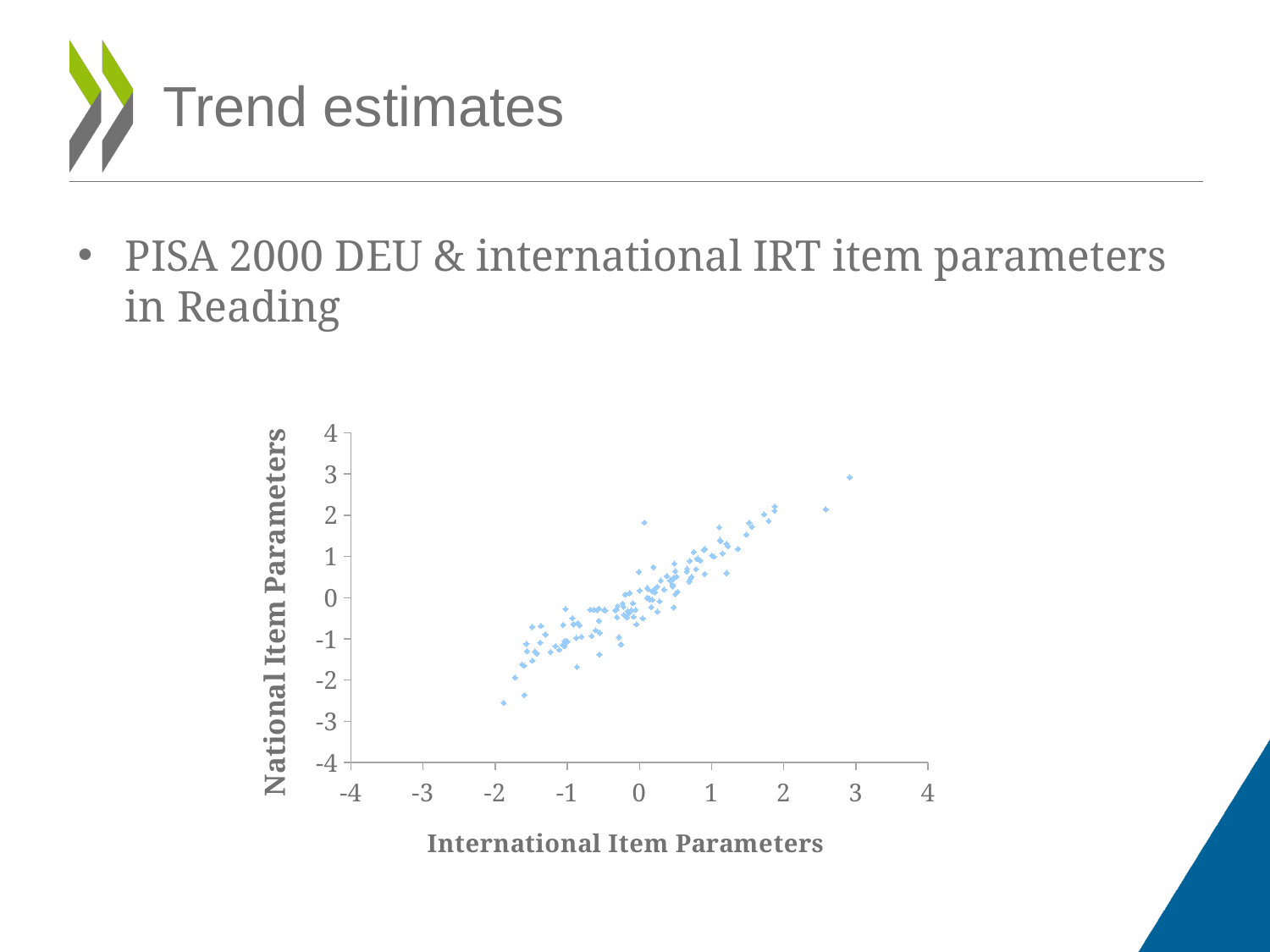
What is the maximum value shown on the y axis of the chart? 4 Is the highest national item parameter plotted on the chart greater or less than 2? greater What is the title of the y axis of the chart? National Item Parameters Is the lowest national item parameter plotted on the chart greater or less than -2? less Is the smallest international item parameter plotted on the chart greater or less than -1? less What kind of chart is shown on the slide? scatter plot As the international item parameters increase along the x axis, do the national item parameters generally rise or fall? rise What is the minimum value shown on the x axis of the chart? -4